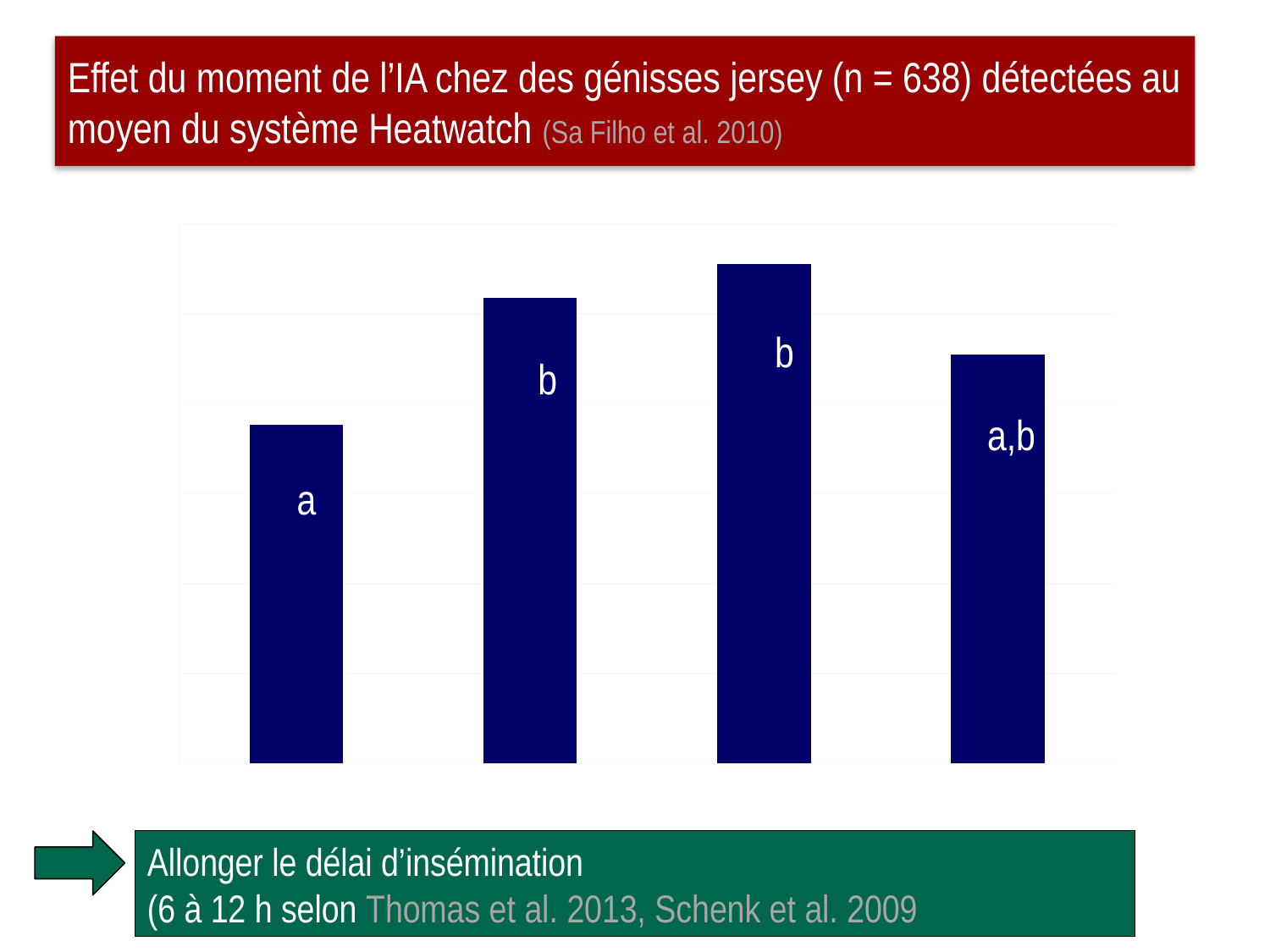
Which bar is the tallest in the chart? the third bar (labelled b) Is the first bar taller or shorter than the third bar? shorter What kind of chart is shown on the slide? bar chart Which bar is the shortest in the chart? the first bar (labelled a) How many bars does the chart contain? 4 What label is printed on the fourth bar? a,b Do the bars rise steadily from left to right across the chart? no What letter label is printed on the first bar? a Is the second bar taller or shorter than the fourth bar? taller